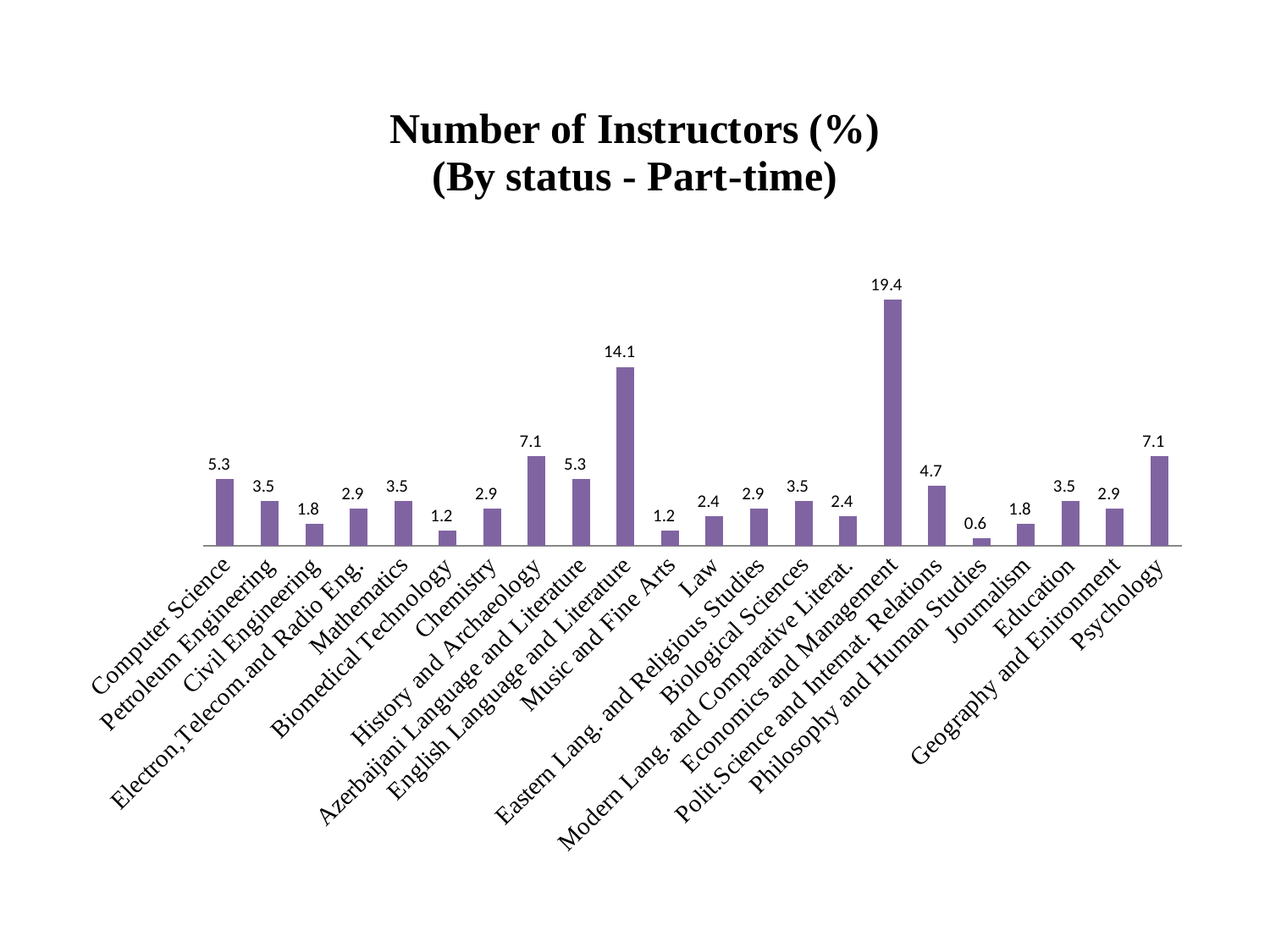
Which is larger, the value for Psychology or the value for Education? Psychology What is the value for Economics and Management? 19.4 What is the difference between the values for Economics and Management and English Language and Literature? 5.3 What is the value for Polit.Science and Internat. Relations? 4.7 What type of chart is shown on the slide? Bar chart What is the difference between the values for History and Archaeology and Computer Science? 1.8 What is the value for English Language and Literature? 14.1 What is the value for Biomedical Technology? 1.2 Which category has the lowest value? Philosophy and Human Studies How many categories are shown on the chart? 22 Which category has the highest value? Economics and Management What is the title of the chart? Number of Instructors (%) (By status - Part-time)